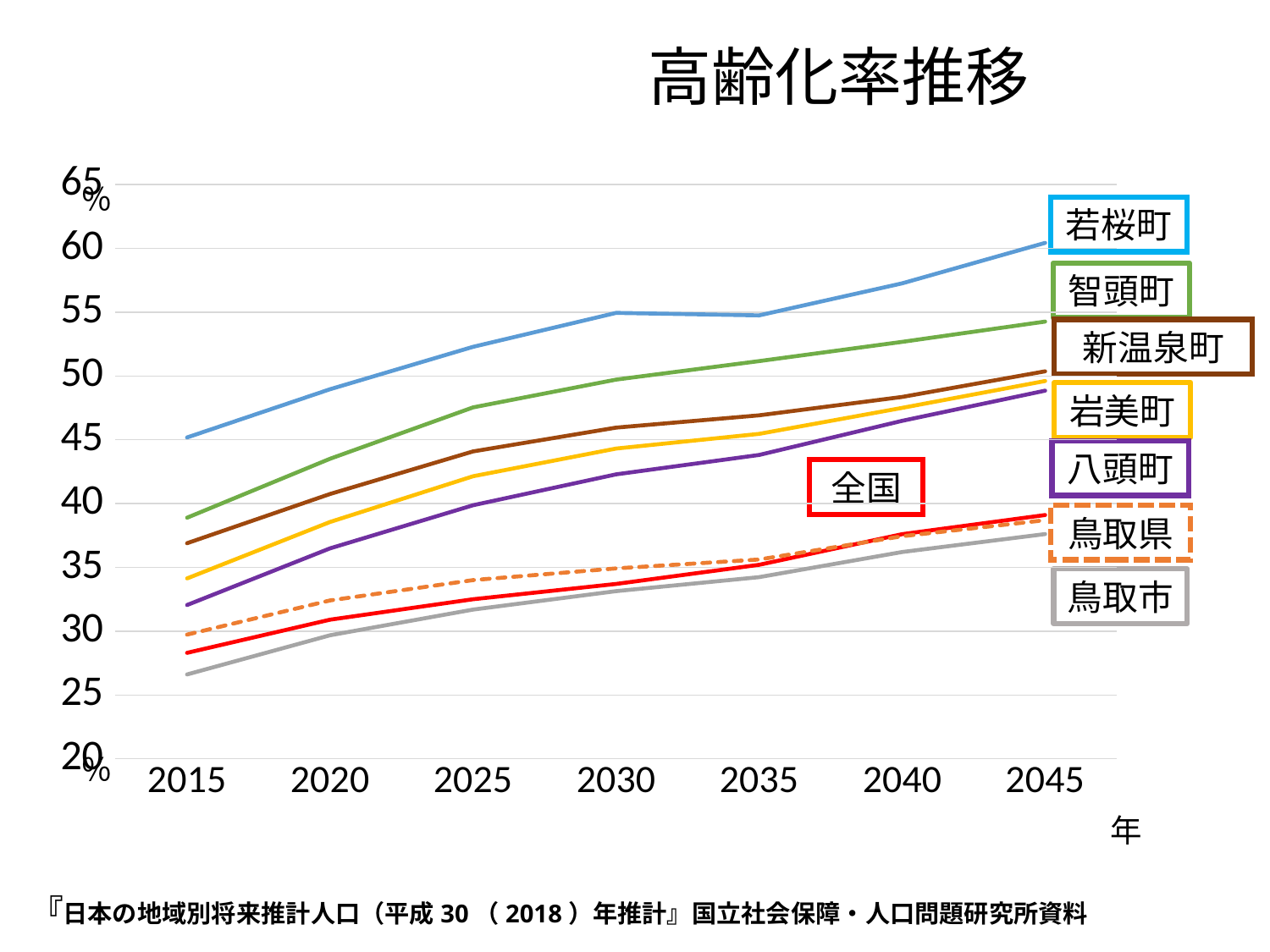
What is the title of the chart? 高齢化率推移 Which series has the highest value in 2045? 若桜町 Which series has the lowest value in 2015? 鳥取市 Is the value for 鳥取市 in 2015 greater or less than 30? less In 2045, which is larger, 智頭町 or 八頭町? 智頭町 Is the value for 若桜町 in 2030 greater or less than 50? greater How many years are shown along the x axis? 7 Which series is drawn with a dashed line? 鳥取県 What kind of chart is shown on the slide? line chart How many series are labelled on the chart? 8 Does the value for 若桜町 rise or fall from 2015 to 2045? rise Is the value for 全国 in 2025 greater or less than 35? less